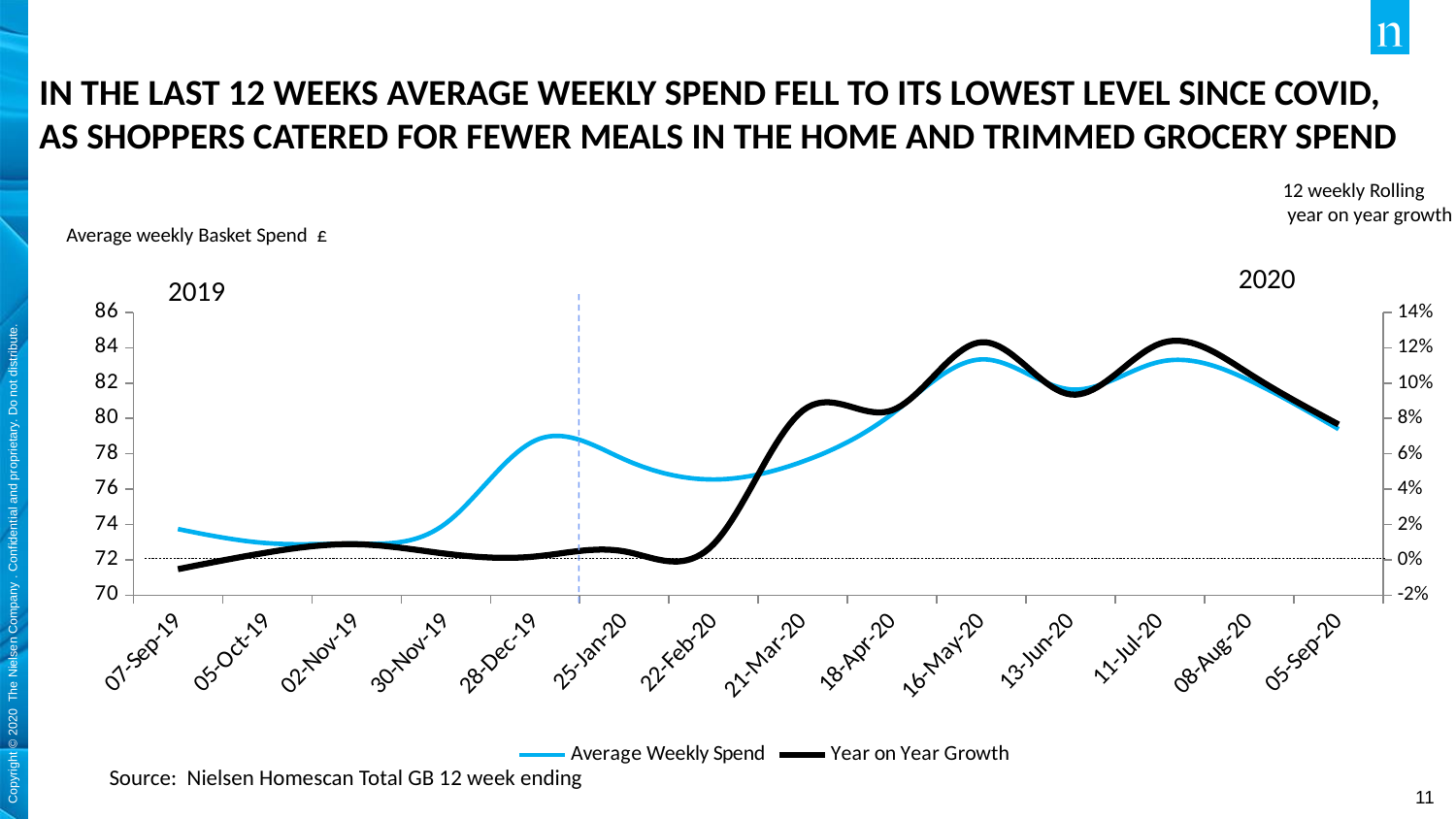
What are the two series named in the chart legend? Average Weekly Spend and Year on Year Growth Which is larger, the Average Weekly Spend for 28-Dec-19 or for 22-Feb-20? 28-Dec-19 How many series does the chart legend list? 2 Is the Year on Year Growth value for 05-Sep-20 greater or less than 10%? less Is the Year on Year Growth value for 16-May-20 greater or less than 10%? greater What kind of chart is shown on the slide? line chart Is the Average Weekly Spend value for 28-Dec-19 greater or less than 76? greater How many dates are labelled along the x axis of the chart? 14 Does the Average Weekly Spend line rise or fall between 22-Feb-20 and 16-May-20? rise